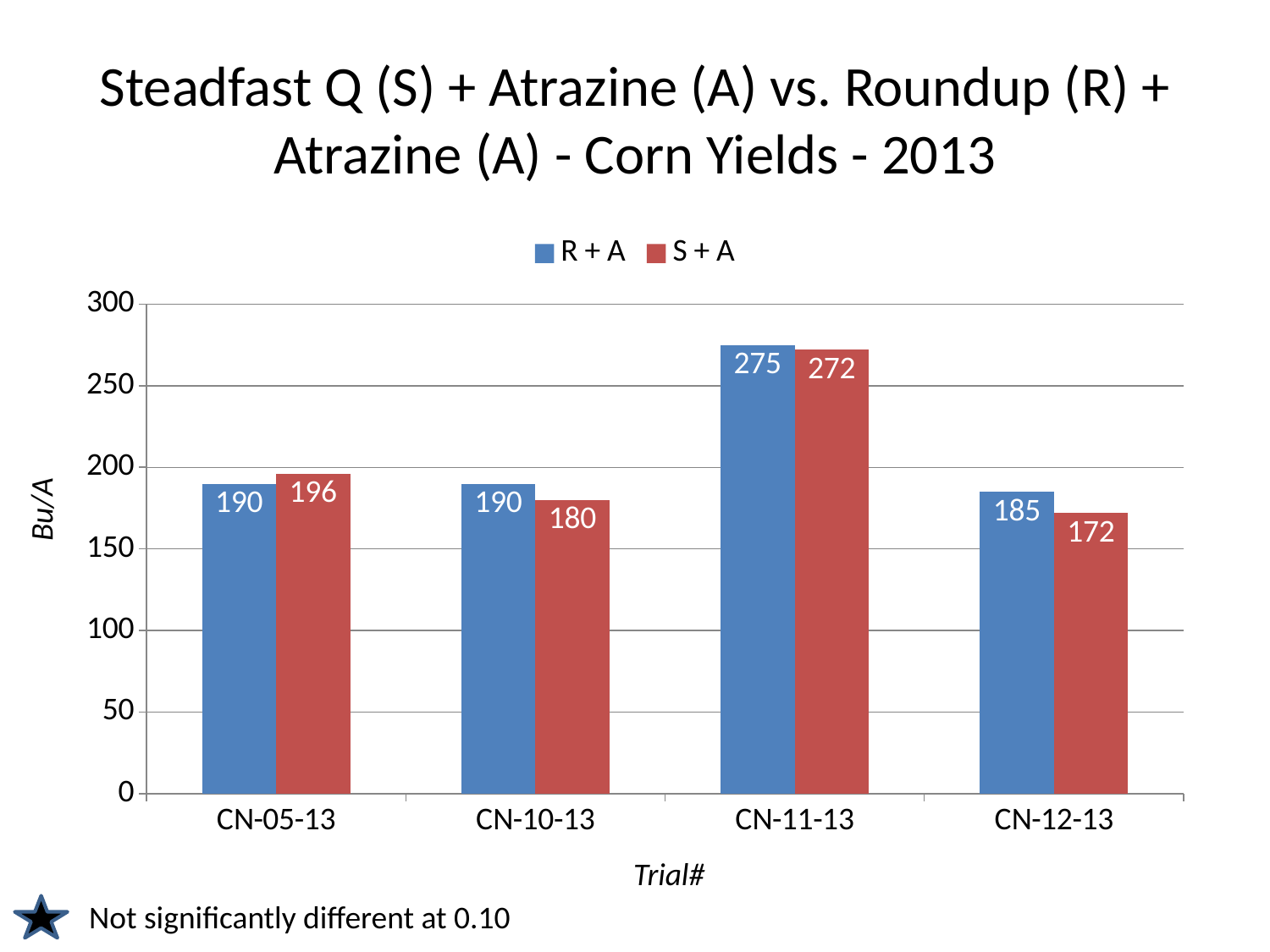
What kind of chart is shown on the slide? bar chart How many trials are shown on the x axis? 4 What is the label of the y axis? Bu/A Is the S + A value for trial CN-11-13 greater or less than 250? greater What is the difference between the R + A and S + A values for trial CN-10-13? 10 What is the S + A value for trial CN-12-13? 172 Which trial has the lowest S + A value? CN-12-13 What is the S + A value for trial CN-05-13? 196 What is the R + A value for trial CN-11-13? 275 How many series does the legend list? 2 Which trial has the highest R + A value? CN-11-13 For trial CN-12-13, which is larger: R + A or S + A? R + A